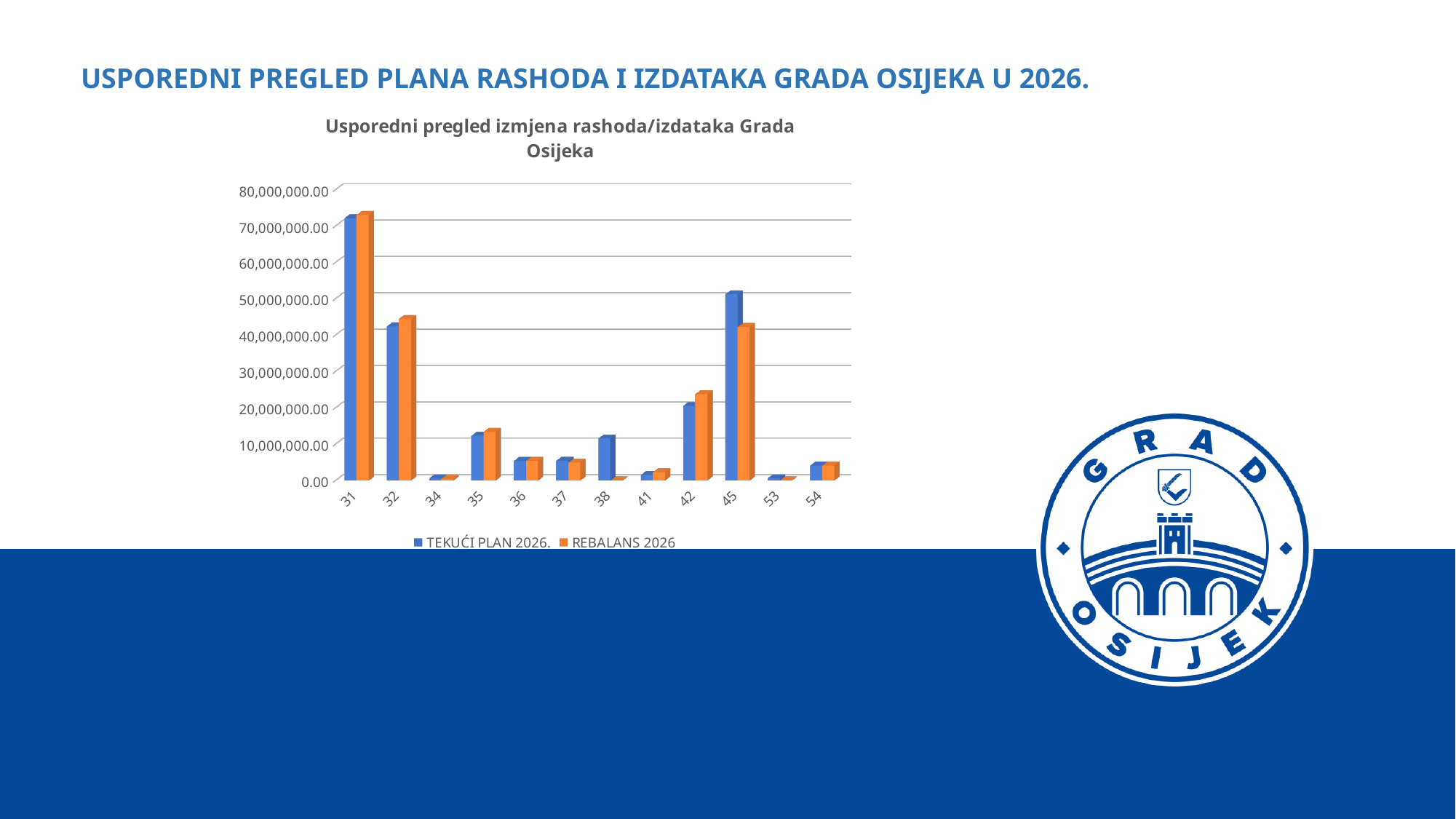
Which category has the highest value for TEKUĆI PLAN 2026.? 31 What kind of chart is shown on the slide? bar chart How many series does the chart legend list? 2 Which category has the highest value for REBALANS 2026? 31 Is the REBALANS 2026 value for category 45 greater or less than 50,000,000.00? less How many categories are shown on the x axis of the chart? 12 Is the TEKUĆI PLAN 2026. value for category 31 greater or less than 70,000,000.00? greater For category 45, which series has the larger value, TEKUĆI PLAN 2026. or REBALANS 2026? TEKUĆI PLAN 2026. What is the title of the chart? Usporedni pregled izmjena rashoda/izdataka Grada Osijeka For category 38, which series has the larger value, TEKUĆI PLAN 2026. or REBALANS 2026? TEKUĆI PLAN 2026. Is the REBALANS 2026 value for category 42 greater or less than 20,000,000.00? greater